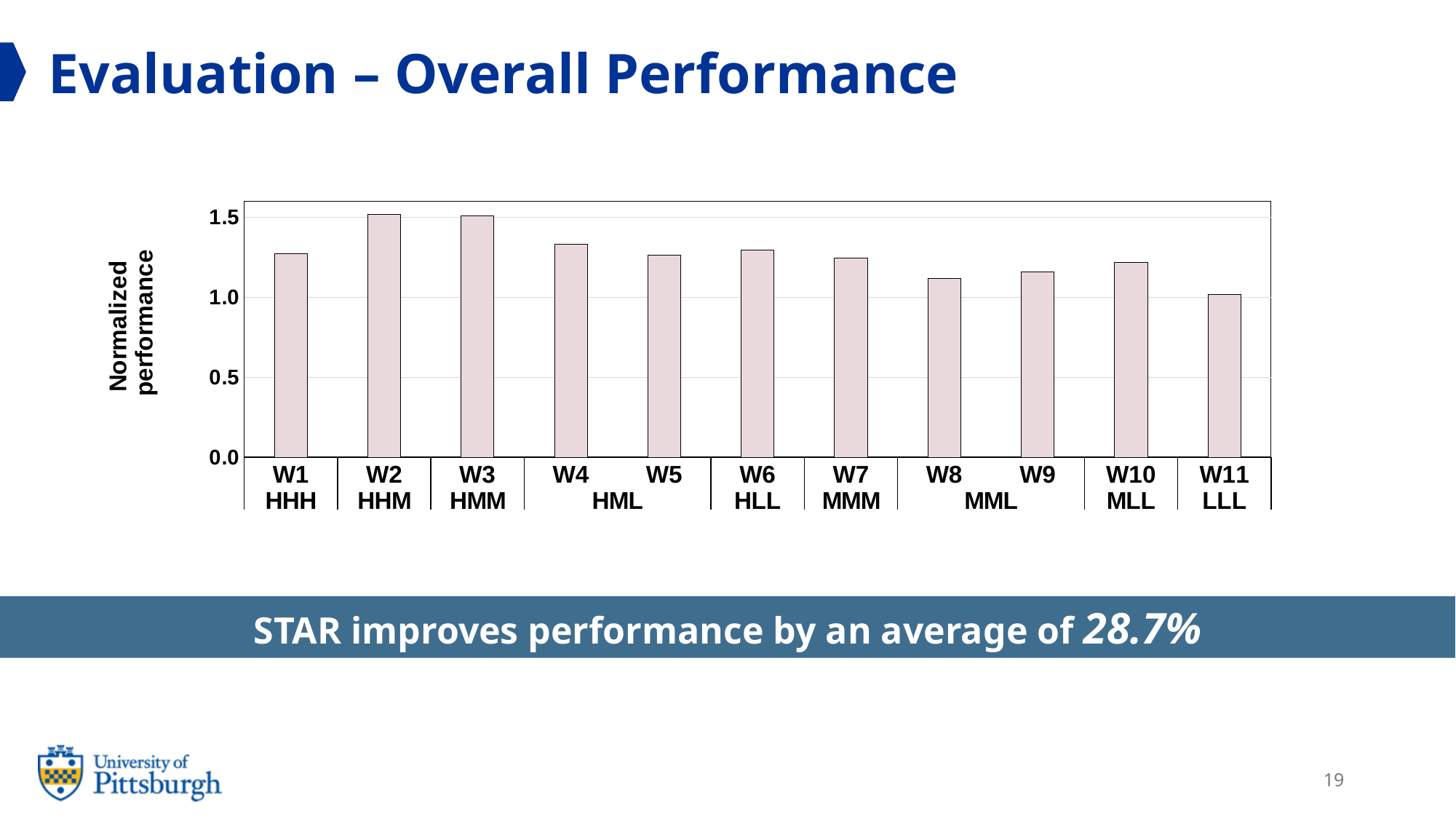
Which has a higher normalized performance, W3 or W9? W3 Is the normalized performance for W7 greater or less than 1.0? greater Is the normalized performance for W8 greater or less than 1.0? greater Is the normalized performance for W1 greater or less than 1.5? less Which has a higher normalized performance, W2 or W11? W2 What is the label of the y-axis? Normalized performance How many workloads (bars) are plotted in the chart? 11 What is the highest value shown on the y-axis? 1.5 Which workload has the lowest normalized performance? W11 Which has a higher normalized performance, W4 or W8? W4 What kind of chart is shown on the slide? bar chart